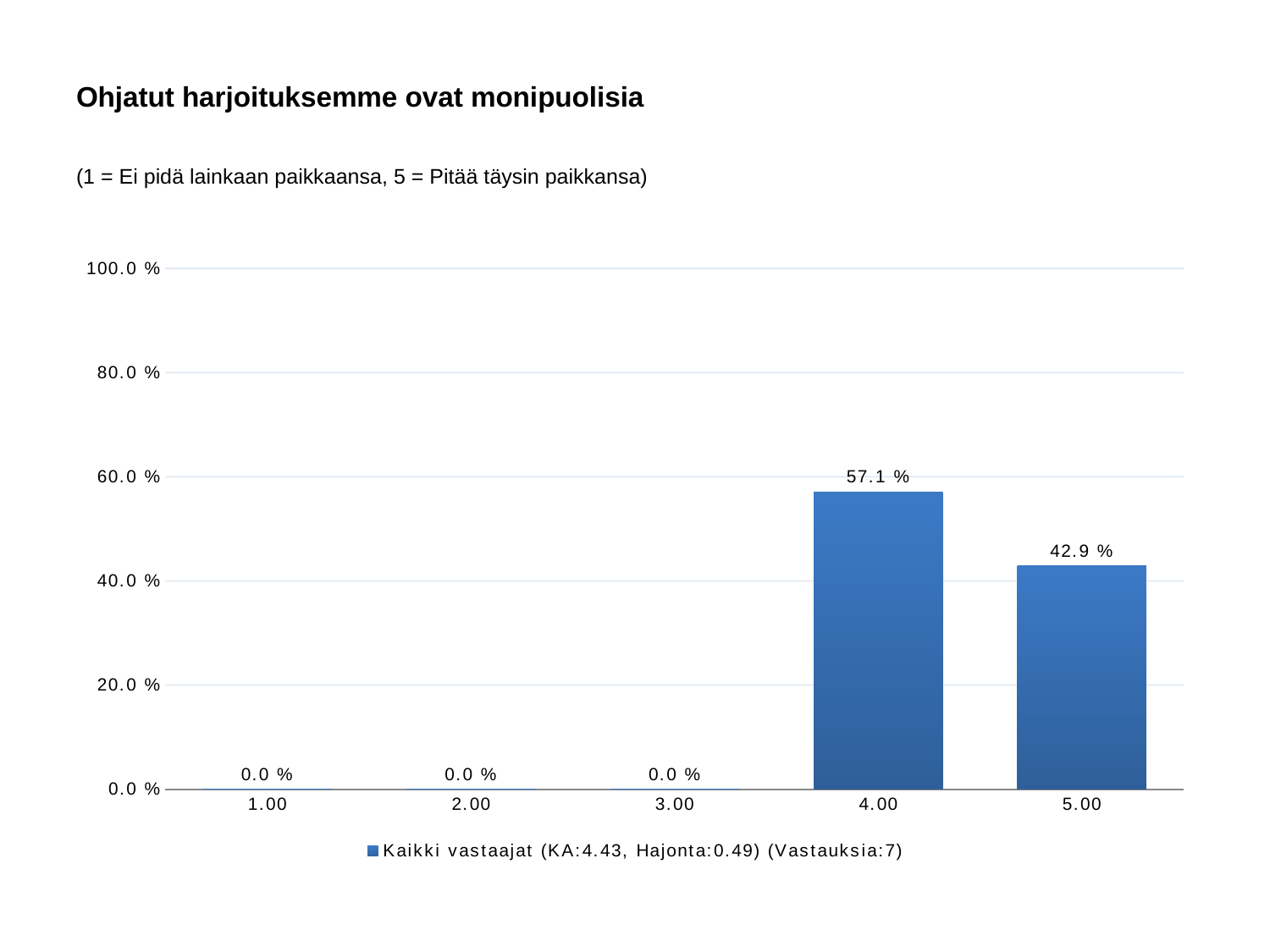
Is the value for 4.00 greater or less than 40.0 %? greater What kind of chart is shown? bar chart What is the value for category 4.00? 57.1 % Which category has the highest value? 4.00 How many categories are shown on the x axis? 5 What is the value for category 5.00? 42.9 % What is the total of the values for 4.00 and 5.00? 100.0 % What is the value for category 1.00? 0.0 % Which is larger, the value for 4.00 or the value for 5.00? 4.00 What is the title of the chart? Ohjatut harjoituksemme ovat monipuolisia What is the difference between the values for 4.00 and 5.00? 14.2 % How many series does the legend list? 1